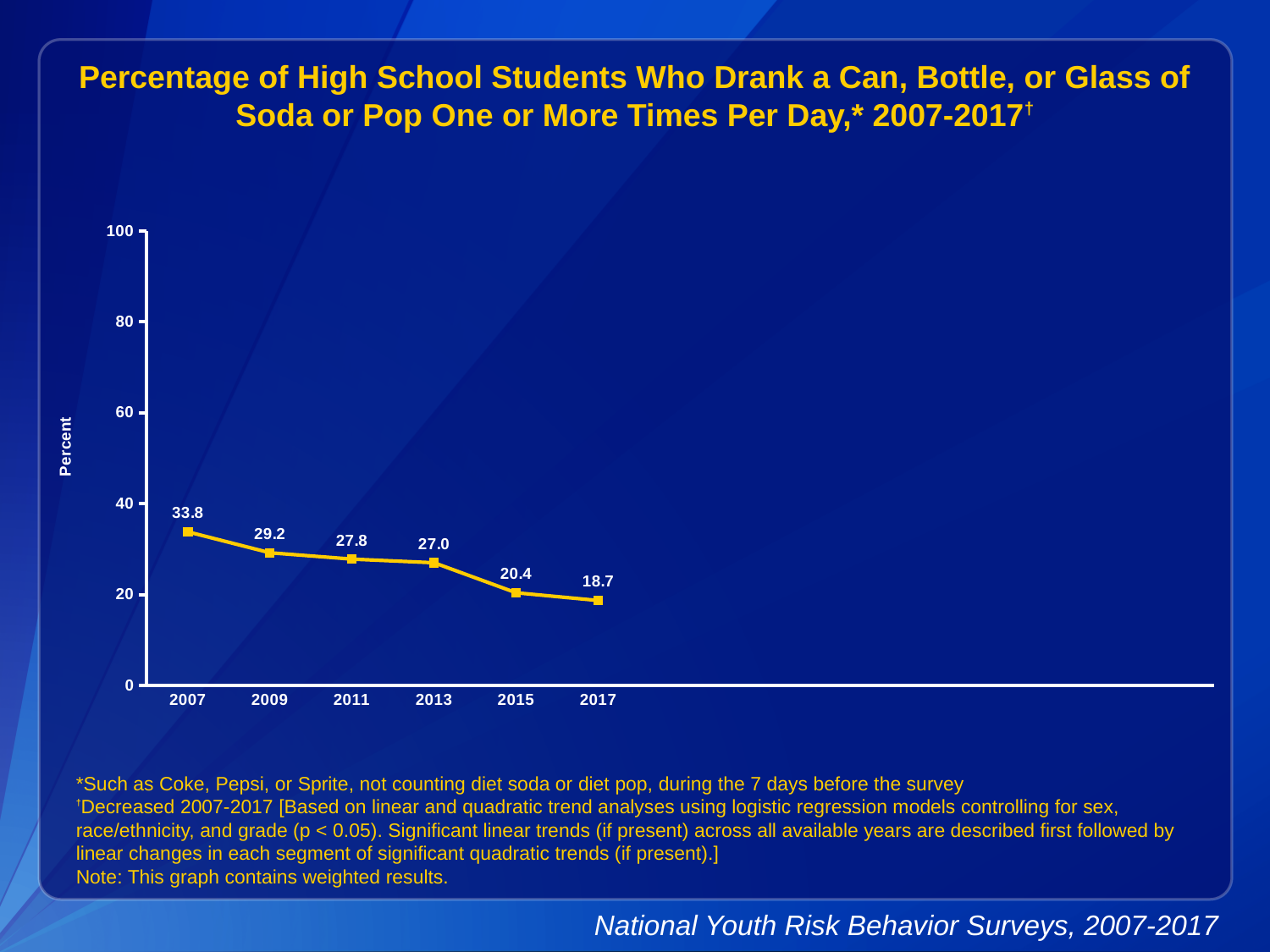
What kind of chart is shown on the slide? line chart What is the difference between the 2007 value and the 2017 value? 15.1 What percentage of high school students drank soda or pop one or more times per day in 2007? 33.8 Which year has the lowest value on the chart? 2017 Is the value for 2011 greater or less than 40? less What is the value plotted for 2017? 18.7 What is the value plotted for 2013? 27.0 How many years are plotted on the chart? 6 Do the values rise or fall from 2007 to 2017? fall What is the difference between the 2013 value and the 2015 value? 6.6 Which year has the highest value on the chart? 2007 Which year has a larger value, 2009 or 2015? 2009